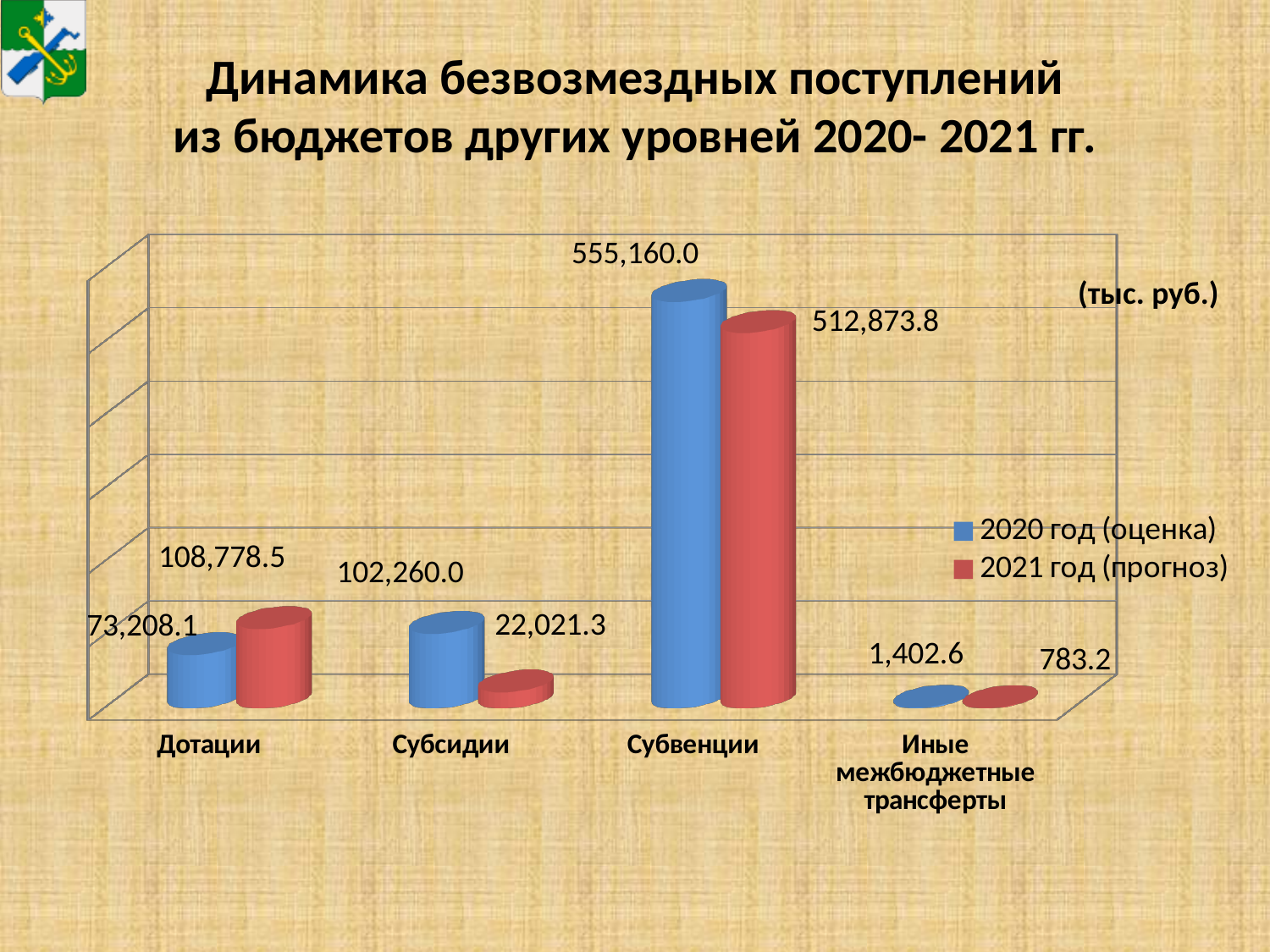
What kind of chart is shown on the slide? Bar chart What is the value for Субсидии in the 2021 год (прогноз) series? 22,021.3 Which category has the lowest value in the 2021 год (прогноз) series? Иные межбюджетные трансферты How many categories are shown on the x axis? 4 What is the value for Дотации in the 2021 год (прогноз) series? 108,778.5 What is the difference between the 2020 год (оценка) and 2021 год (прогноз) values for Субвенции? 42,286.2 What is the value for Иные межбюджетные трансферты in the 2020 год (оценка) series? 1,402.6 What is the value for Дотации in the 2020 год (оценка) series? 73,208.1 How many series does the legend list? 2 For Дотации, which series has the larger value: 2020 год (оценка) or 2021 год (прогноз)? 2021 год (прогноз) Which category has the highest value in the 2020 год (оценка) series? Субвенции What is the difference between the 2020 год (оценка) and 2021 год (прогноз) values for Субсидии? 80,238.7